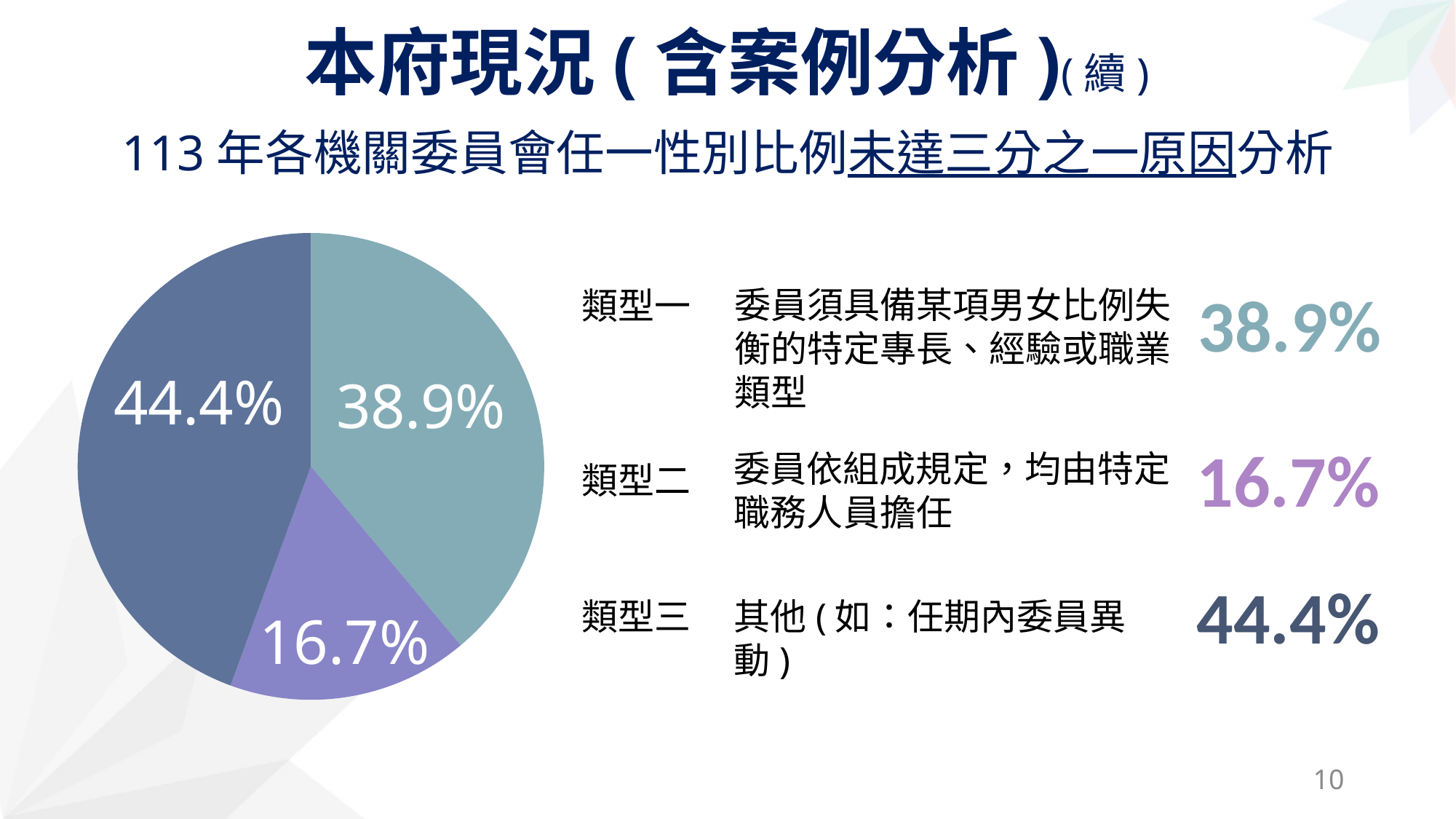
What kind of chart is shown on the slide? pie chart How many slices does the pie chart have? 3 What is the difference in percentage points between 類型一 and 類型二? 22.2 What colour is the slice representing 類型二 (16.7%)? purple Which category has the smallest slice of the pie? 類型二 What is the subtitle describing the pie chart's subject? 113年各機關委員會任一性別比例未達三分之一原因分析 Which is larger, the share for 類型一 or the share for 類型二? 類型一 What share of the pie does 類型三 (其他) account for? 44.4% What share of the pie does 類型一 (委員須具備某項男女比例失衡的特定專長、經驗或職業類型) account for? 38.9% What is the difference in percentage points between 類型三 and 類型一? 5.5 What share of the pie does 類型二 (委員依組成規定，均由特定職務人員擔任) account for? 16.7% Which category has the largest slice of the pie? 類型三 (其他)